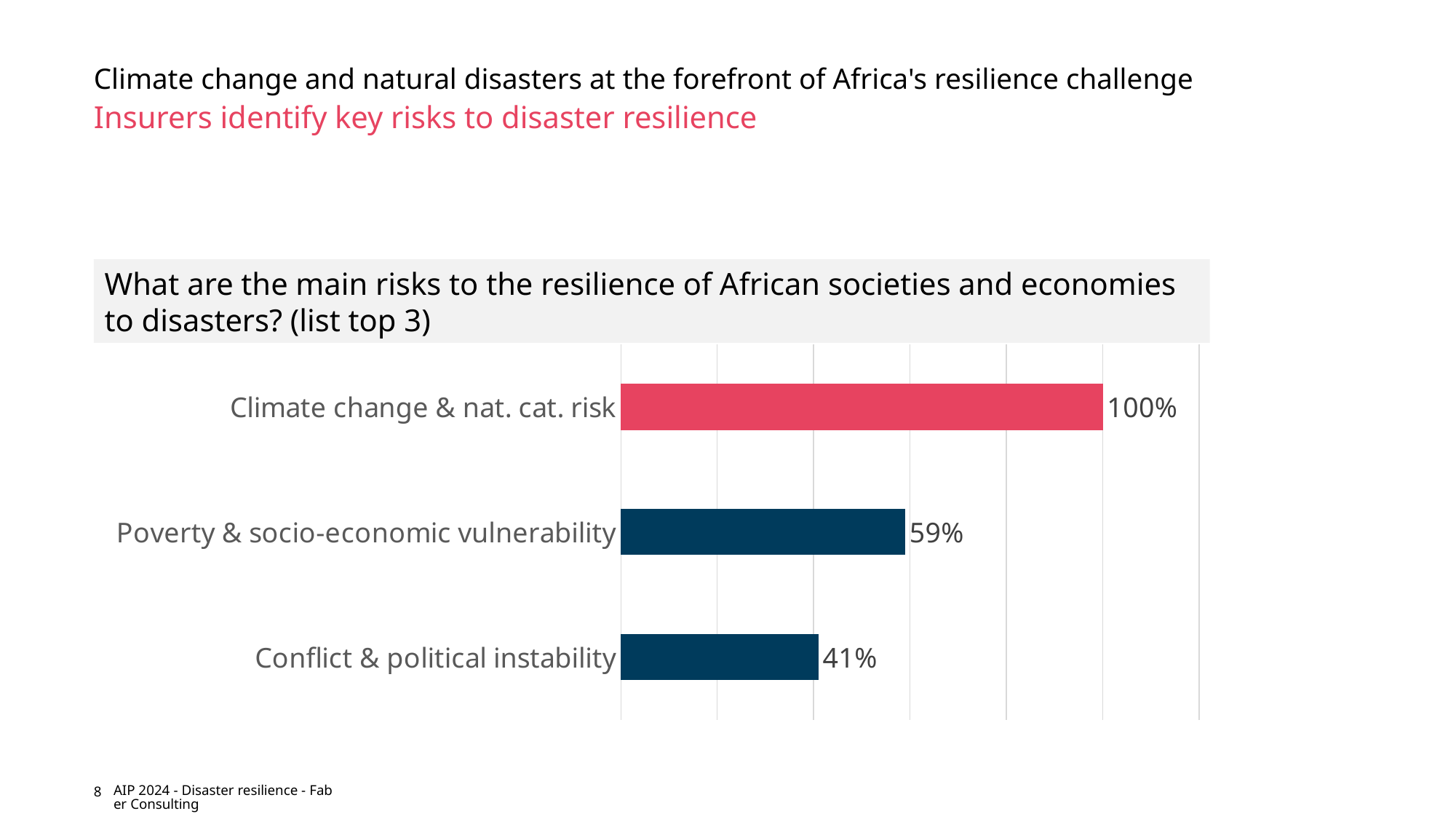
Which bar is coloured differently (red) from the others? Climate change & nat. cat. risk What kind of chart is shown on the slide? Bar chart What question does the chart's title ask? What are the main risks to the resilience of African societies and economies to disasters? (list top 3) What is the difference between the values for Poverty & socio-economic vulnerability and Conflict & political instability? 18% Which is larger: the value for Poverty & socio-economic vulnerability or the value for Conflict & political instability? Poverty & socio-economic vulnerability What is the difference between the values for Climate change & nat. cat. risk and Poverty & socio-economic vulnerability? 41% What is the value for Conflict & political instability? 41% Which category has the highest value? Climate change & nat. cat. risk How many categories are shown in the chart? 3 What is the value for Climate change & nat. cat. risk? 100% Which category has the lowest value? Conflict & political instability What is the value for Poverty & socio-economic vulnerability? 59%